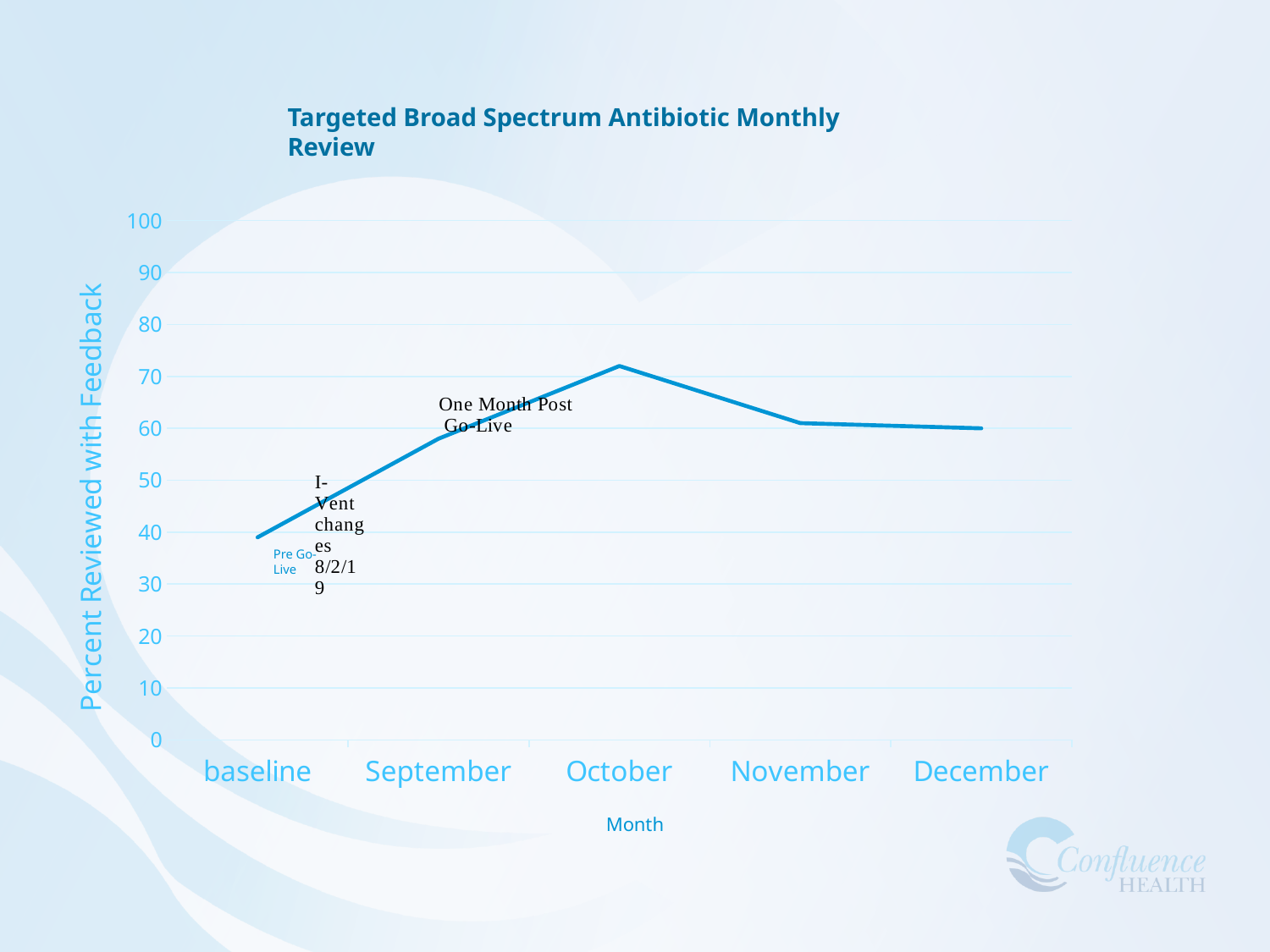
Which category has the lowest percent reviewed with feedback? baseline Do the values rise or fall from baseline to October? rise Is the value for baseline greater or less than 30? greater Which is larger, the value for September or the value for October? October What kind of chart is shown on the slide? line chart Is the value for November greater or less than 70? less Which month has the highest percent reviewed with feedback? October Is the value for October greater or less than 60? greater Which is larger, the value for baseline or the value for October? October What is the title of the chart? Targeted Broad Spectrum Antibiotic Monthly Review What is the label of the vertical axis? Percent Reviewed with Feedback How many categories are shown on the x axis? 5